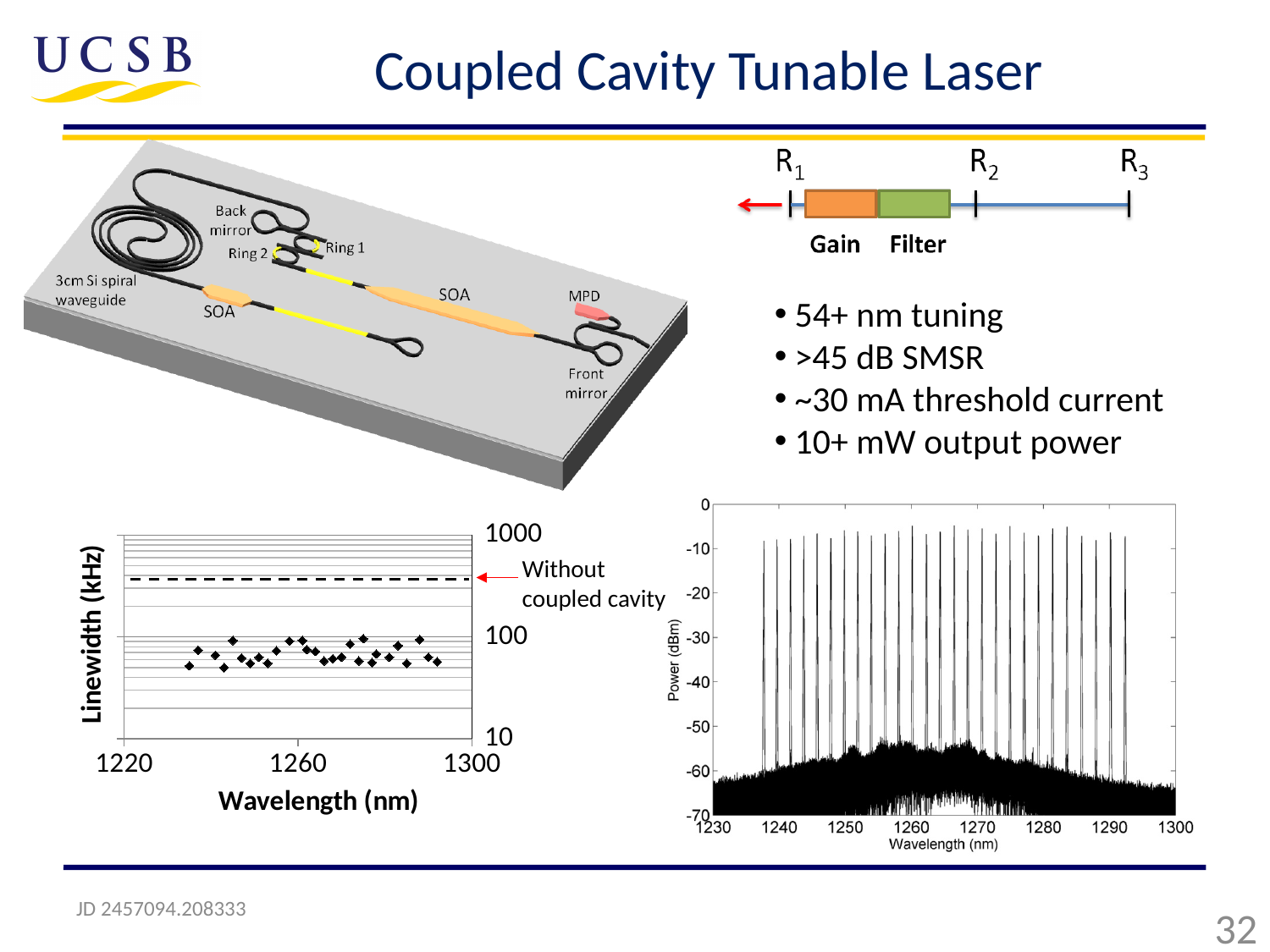
In the lower-left Linewidth chart, is the dashed 'Without coupled cavity' line greater or less than 1000 kHz? less What is the y-axis label of the lower-left chart? Linewidth (kHz) What is the y-axis label of the lower-right chart? Power (dBm) What kind of chart is the Power (dBm) versus Wavelength (nm) chart on the lower right of the slide? line chart In the lower-right Power (dBm) chart, are the tallest spectral peaks greater or less than -20 dBm? greater In the lower-left Linewidth chart, is the dashed 'Without coupled cavity' line greater or less than 100 kHz? greater What kind of chart is the Linewidth (kHz) versus Wavelength (nm) chart on the lower left of the slide? scatter plot